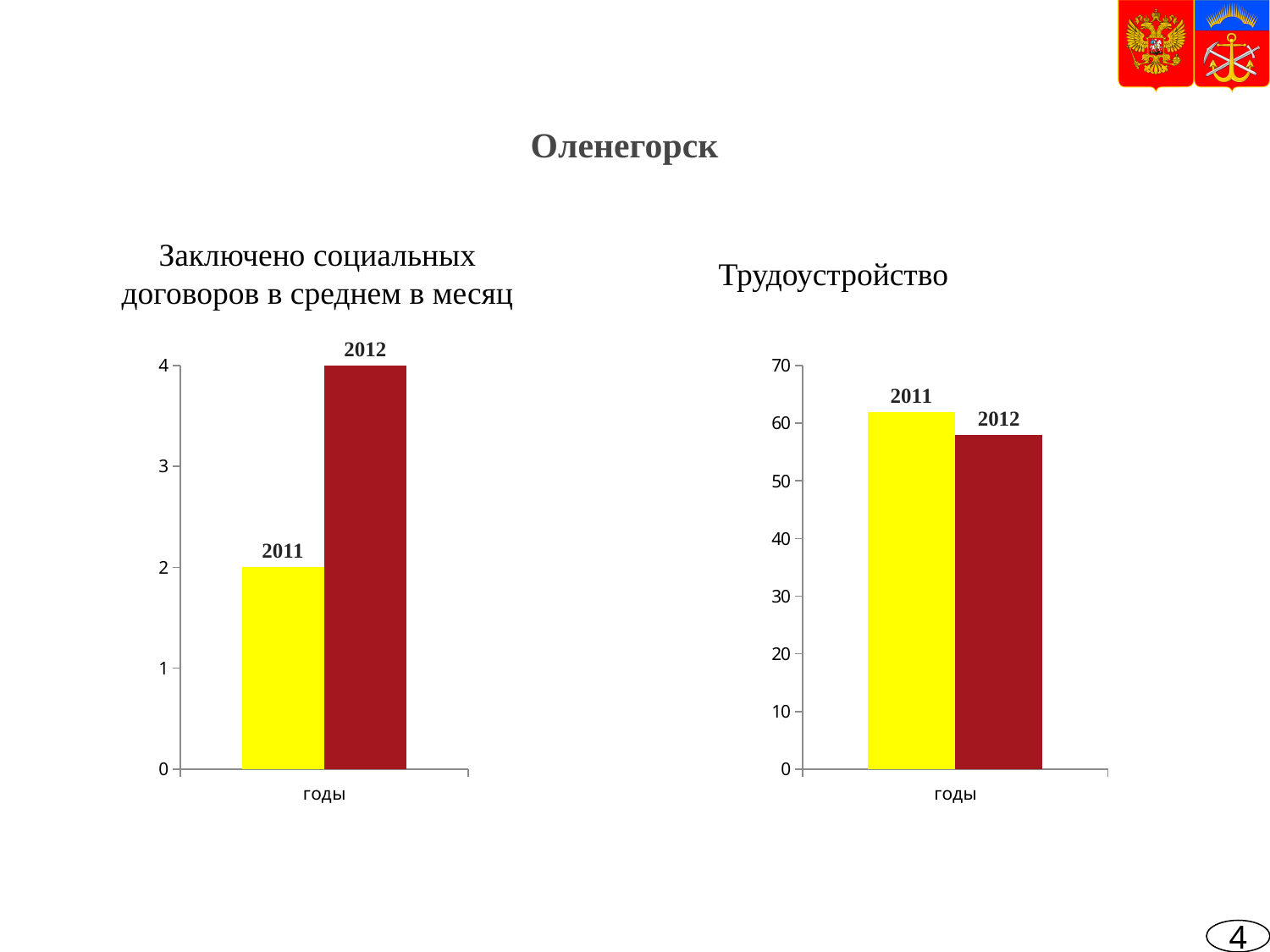
In the left chart 'Заключено социальных договоров в среднем в месяц', which year has the higher value? 2012 In the left chart 'Заключено социальных договоров в среднем в месяц', what is the value for 2011? 2 In the left chart 'Заключено социальных договоров в среднем в месяц', which year has the lower value? 2011 In the left chart 'Заключено социальных договоров в среднем в месяц', what is the value for 2012? 4 In the right chart 'Трудоустройство', which year has the higher value? 2011 In the right chart 'Трудоустройство', is the value for 2012 greater or less than 60? less In the left chart 'Заключено социальных договоров в среднем в месяц', do the values rise or fall from 2011 to 2012? rise In the right chart 'Трудоустройство', is the value for 2011 greater or less than 60? greater In the right chart 'Трудоустройство', do the values rise or fall from 2011 to 2012? fall How many bars are shown in the left chart 'Заключено социальных договоров в среднем в месяц'? 2 In the left chart 'Заключено социальных договоров в среднем в месяц', what is the difference between the 2012 and 2011 values? 2 What kind of chart is the right chart 'Трудоустройство'? bar chart